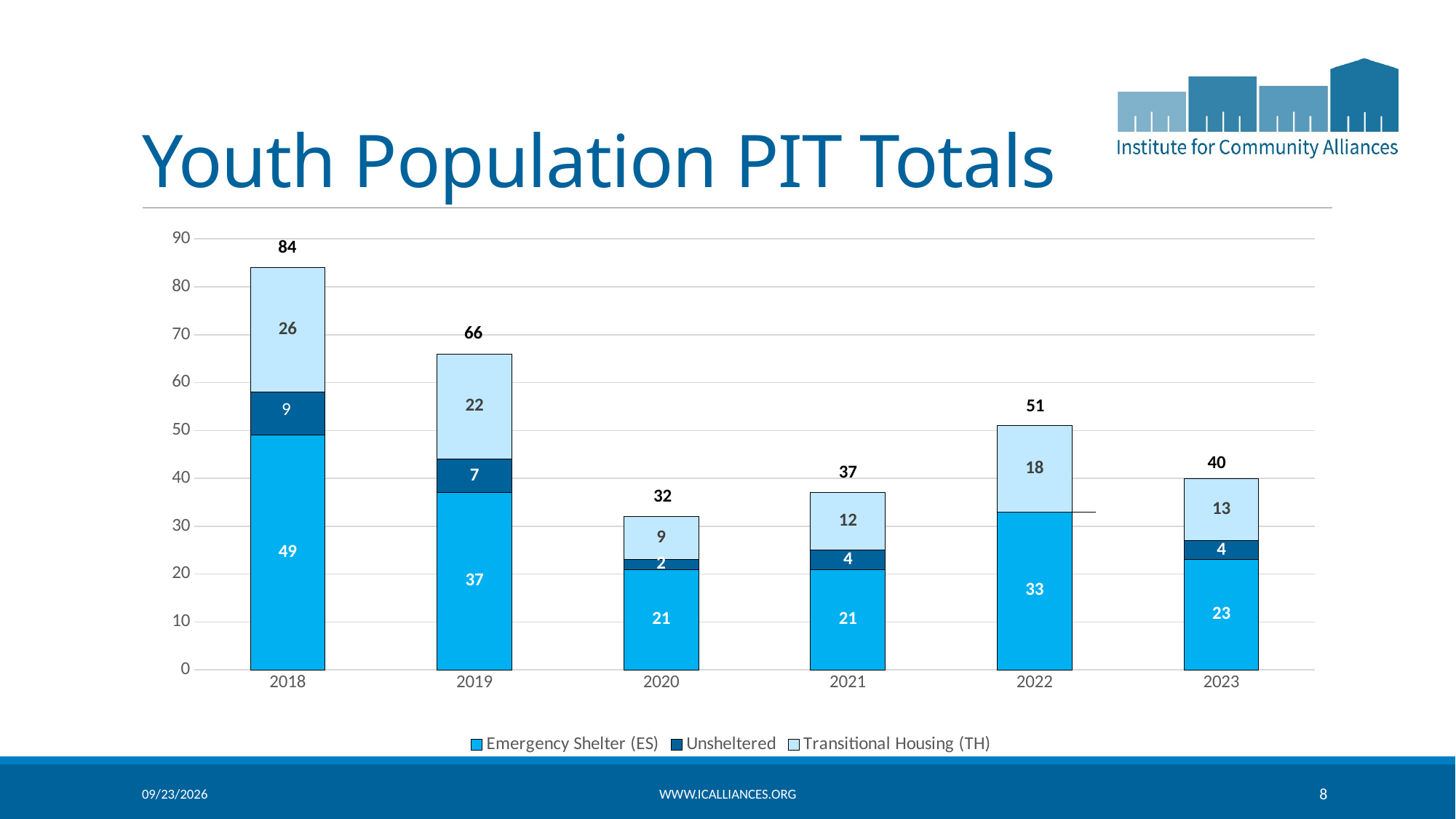
How many years are shown on the x axis? 6 Which year has the highest total? 2018 What is the total for the 2021 bar? 37 What is the Emergency Shelter (ES) value for 2018? 49 Which is larger, the Emergency Shelter (ES) value for 2022 or for 2023? 2022 How many series does the legend list? 3 What is the Unsheltered value for 2020? 2 What kind of chart is shown on the slide? Stacked bar chart Which year has the lowest total? 2020 What is the difference between the 2018 total and the 2019 total? 18 What is the Transitional Housing (TH) value for 2019? 22 What is the title of the slide? Youth Population PIT Totals